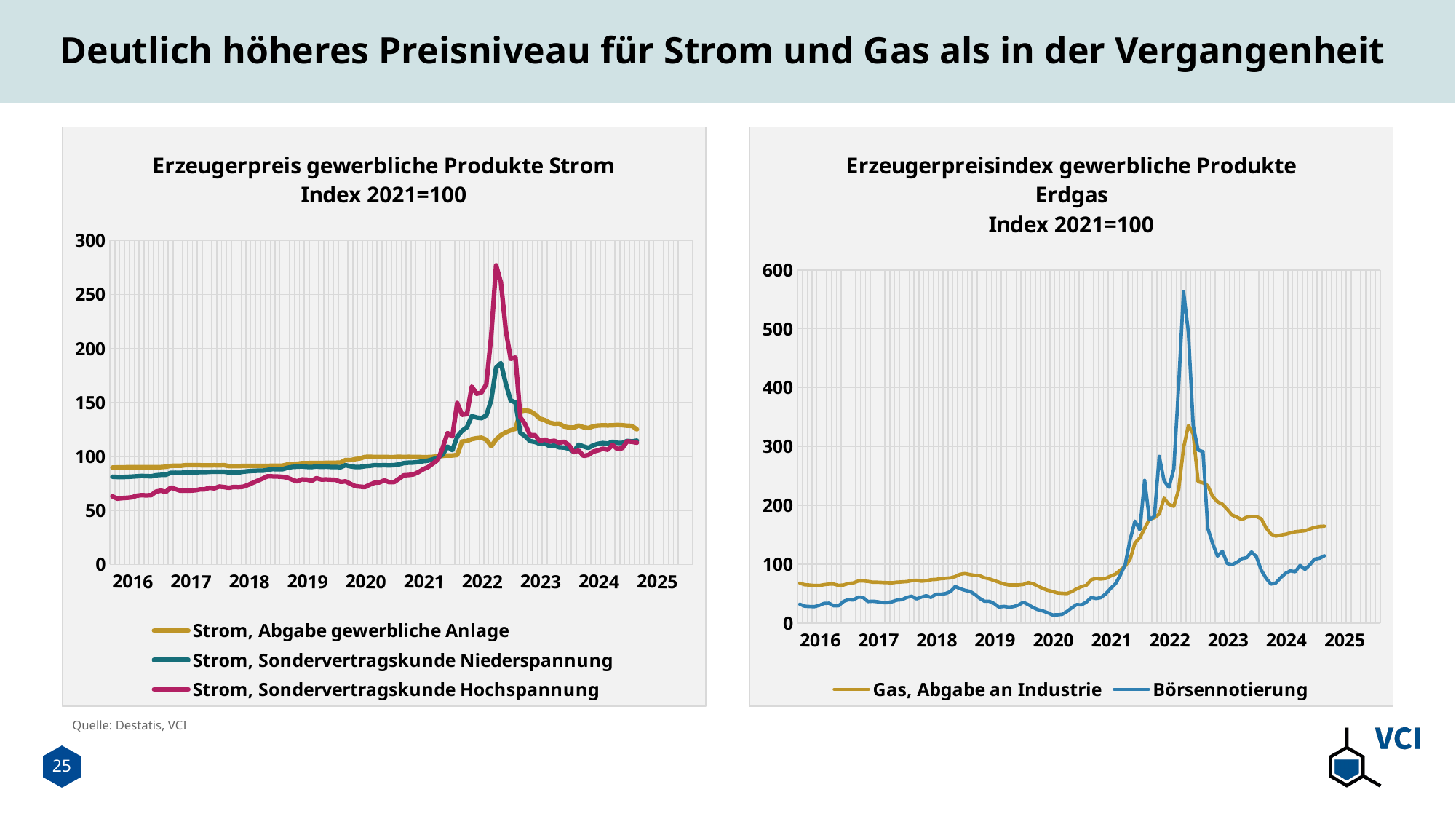
How many series does the legend of the left chart (Strom) list? 3 In the right chart (Erdgas), is the 2022 peak value of 'Gas, Abgabe an Industrie' greater or less than 300? greater What base year is used for the index in both charts, as stated in their titles? 2021=100 In the left chart (Strom), does 'Strom, Abgabe gewerbliche Anlage' rise or fall between 2016 and its 2022 peak? rise In the left chart (Strom), which series reaches the highest peak in 2022? Strom, Sondervertragskunde Hochspannung In the left chart (Strom), is the 2022 peak value of 'Strom, Sondervertragskunde Hochspannung' greater or less than 250? greater In the right chart (Erdgas), is the 2022 peak value of 'Börsennotierung' greater or less than 500? greater What kind of chart is the left chart, 'Erzeugerpreis gewerbliche Produkte Strom'? line chart In the right chart (Erdgas), which series reaches the highest peak in 2022? Börsennotierung How many series does the legend of the right chart (Erdgas) list? 2